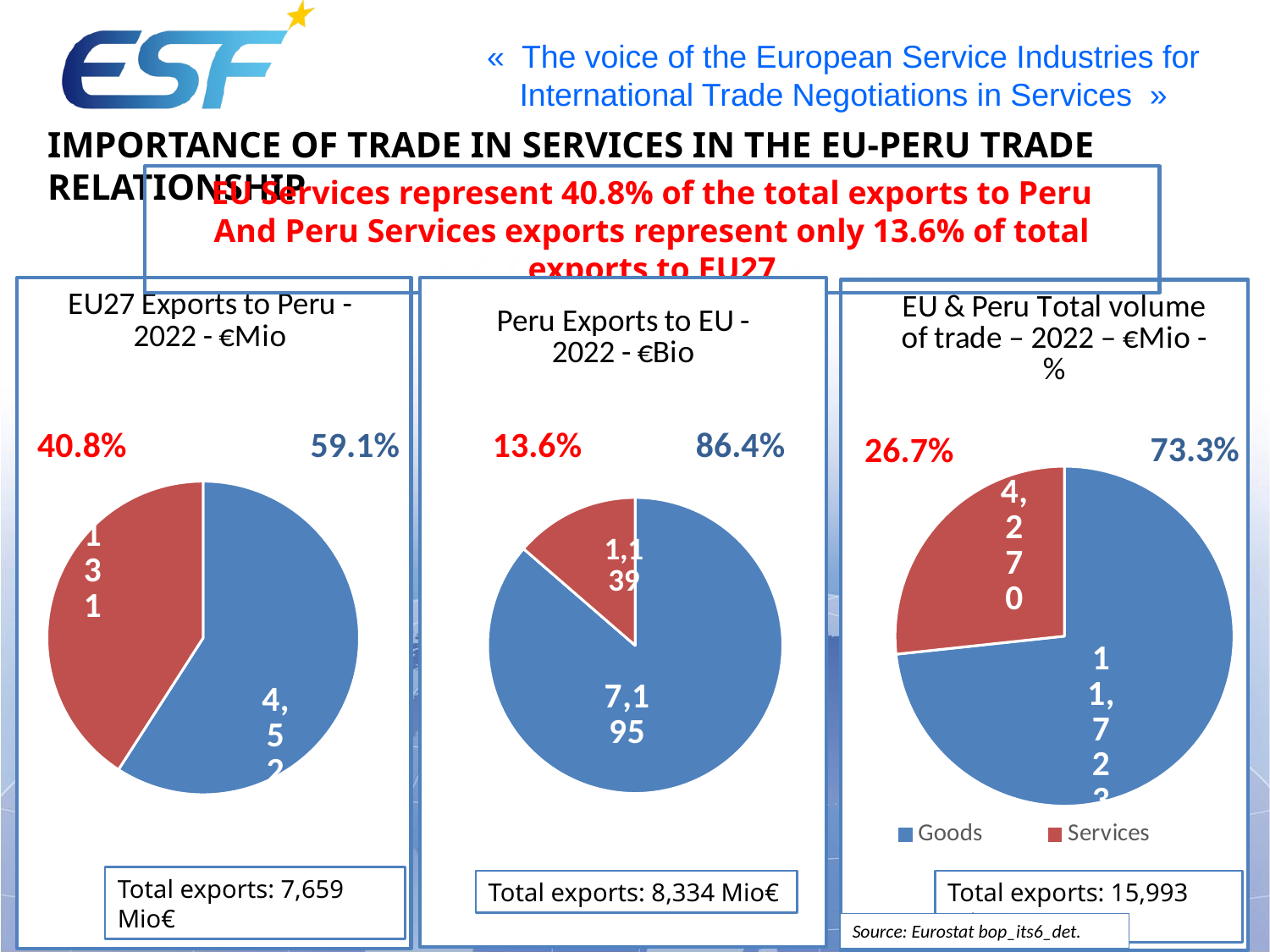
How many slices does the 'Peru Exports to EU - 2022 - €Bio' pie chart have? 2 What two entries does the legend of the 'EU & Peru Total volume of trade – 2022' chart list? Goods and Services In the 'Peru Exports to EU - 2022 - €Bio' chart, what share of the pie is Services? 13.6% In the 'Peru Exports to EU - 2022 - €Bio' chart, which slice is larger, Goods or Services? Goods In the 'Peru Exports to EU - 2022 - €Bio' chart, what is the value shown for Goods? 7,195 In the 'EU27 Exports to Peru - 2022 - €Mio' chart, what share of the pie is Goods? 59.1% In the 'EU27 Exports to Peru - 2022 - €Mio' chart, what share of the pie is Services? 40.8% In the 'EU & Peru Total volume of trade – 2022' chart, what is the value shown for Services? 4,270 What kind of chart is the 'EU27 Exports to Peru - 2022 - €Mio' chart? Pie chart In the 'EU & Peru Total volume of trade – 2022' chart, which slice is the largest? Goods In the 'Peru Exports to EU - 2022 - €Bio' chart, what is the value shown for Services? 1,139